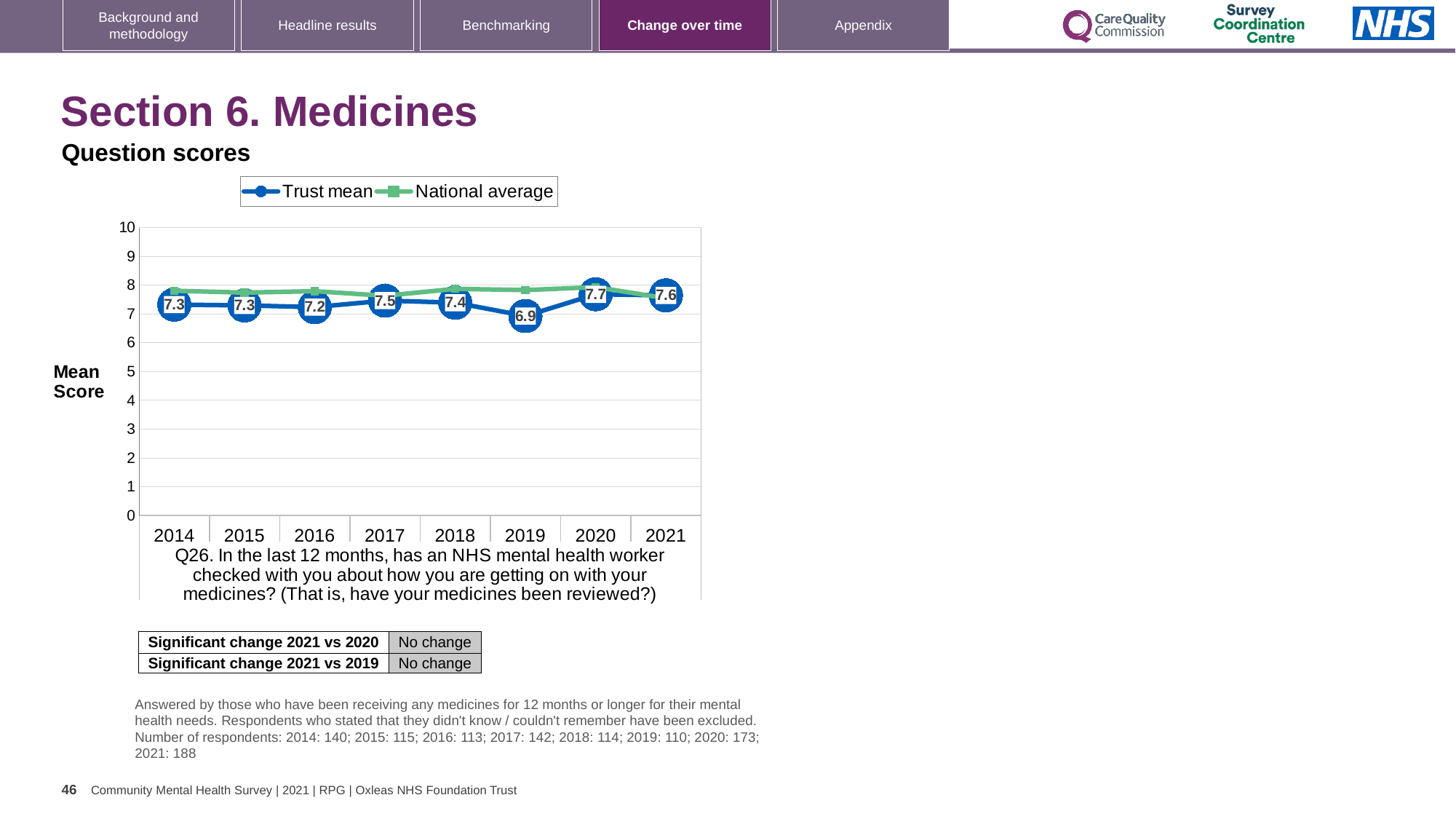
What is the Trust mean score for 2017? 7.5 Is the National average value for 2014 greater or less than 7? greater What is the difference between the Trust mean scores for 2020 and 2019? 0.8 What kind of chart is shown on the slide? Line chart Does the Trust mean score rise or fall from 2019 to 2020? Rise In which year is the Trust mean score lowest? 2019 What is the Trust mean score for 2021? 7.6 How many series does the chart legend list? 2 How many years are shown on the x axis of the chart? 8 In which year is the Trust mean score highest? 2020 What is the Trust mean score for 2019? 6.9 Which is larger, the Trust mean score for 2016 or for 2018? 2018